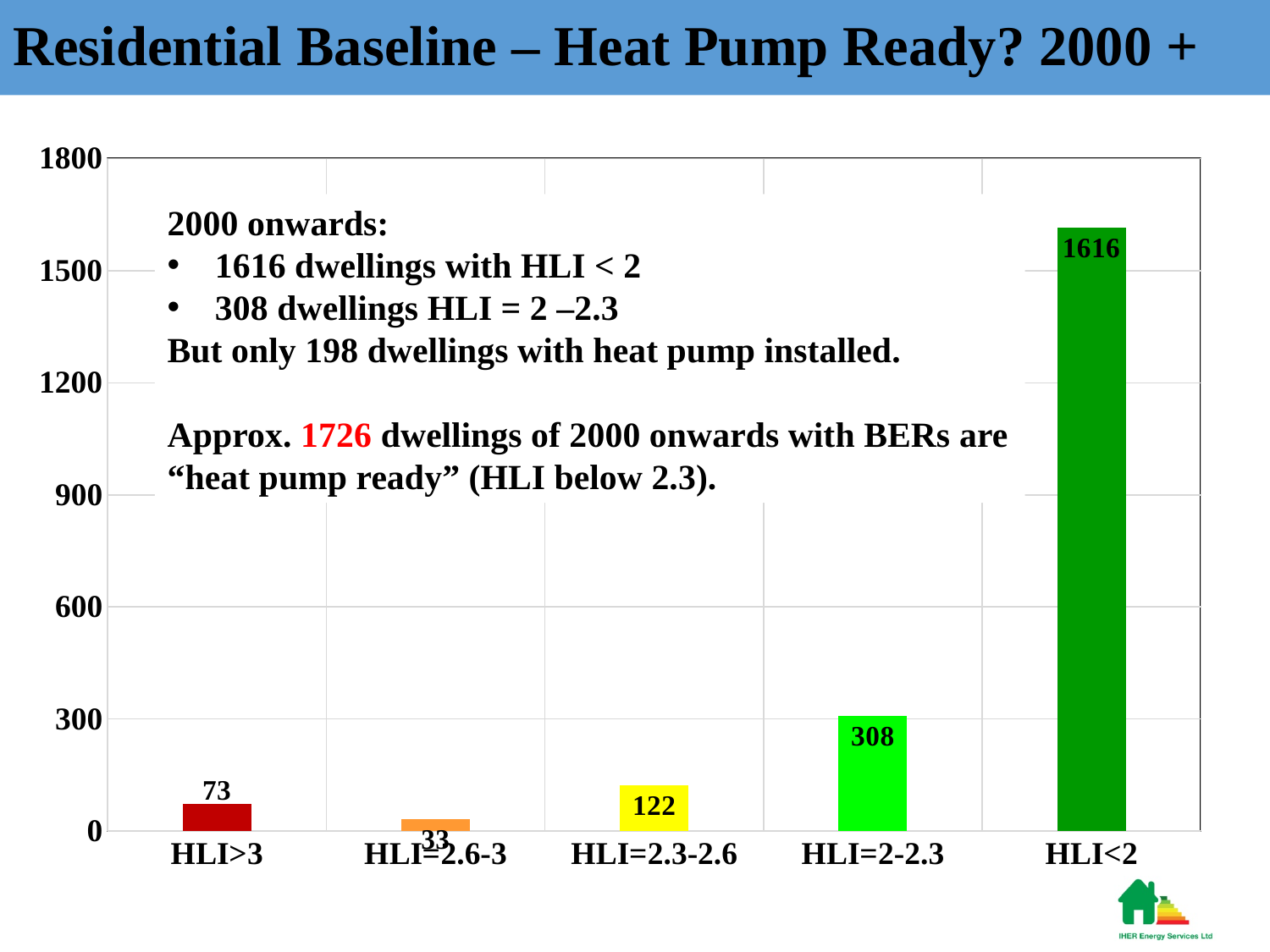
What is the value for HLI>3? 73 How many categories are shown on the x axis of the chart? 5 What kind of chart is shown on the slide? bar chart What is the difference between the values for HLI<2 and HLI=2-2.3? 1308 What is the value for HLI=2.3-2.6? 122 What is the value for HLI=2-2.3? 308 What colour is the bar for HLI>3? red Is the value for HLI<2 greater or less than 1500? greater Which category has the highest value? HLI<2 What is the value for HLI<2? 1616 Which is larger, the value for HLI>3 or the value for HLI=2.3-2.6? HLI=2.3-2.6 Which category has the lowest value? HLI=2.6-3